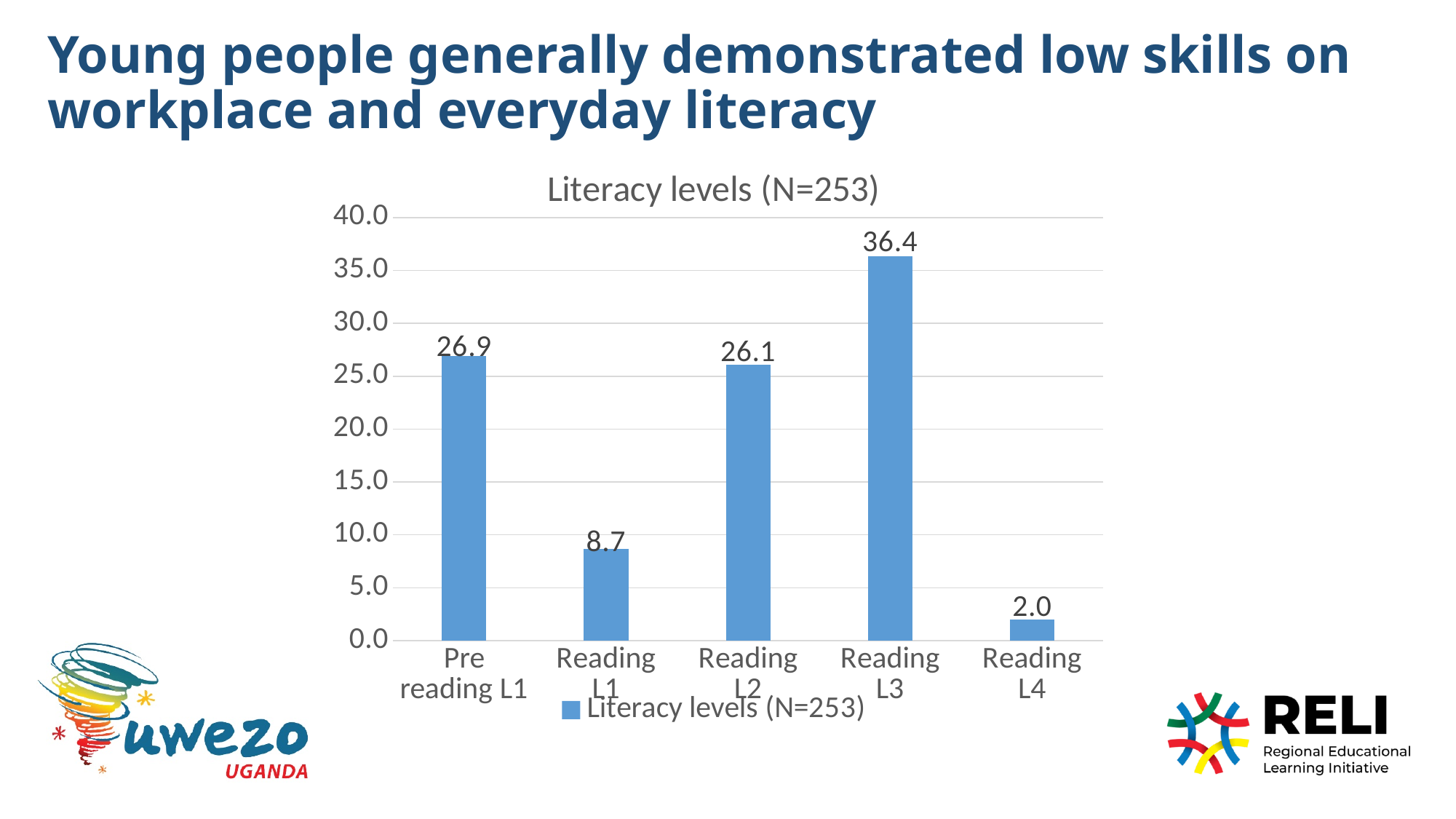
Which category has the lowest value? Reading L4 What is the difference between the values for Reading L3 and Reading L1? 27.7 Which category has the highest value? Reading L3 What is the value for Reading L4? 2.0 Which is larger, the value for Pre reading L1 or the value for Reading L2? Pre reading L1 Is the value for Reading L1 greater or less than 10.0? less How many series does the legend list? 1 What is the value for Reading L3? 36.4 What is the value for Pre reading L1? 26.9 What kind of chart is shown on the slide? bar chart What is the title of the chart? Literacy levels (N=253) How many categories are shown on the x axis? 5